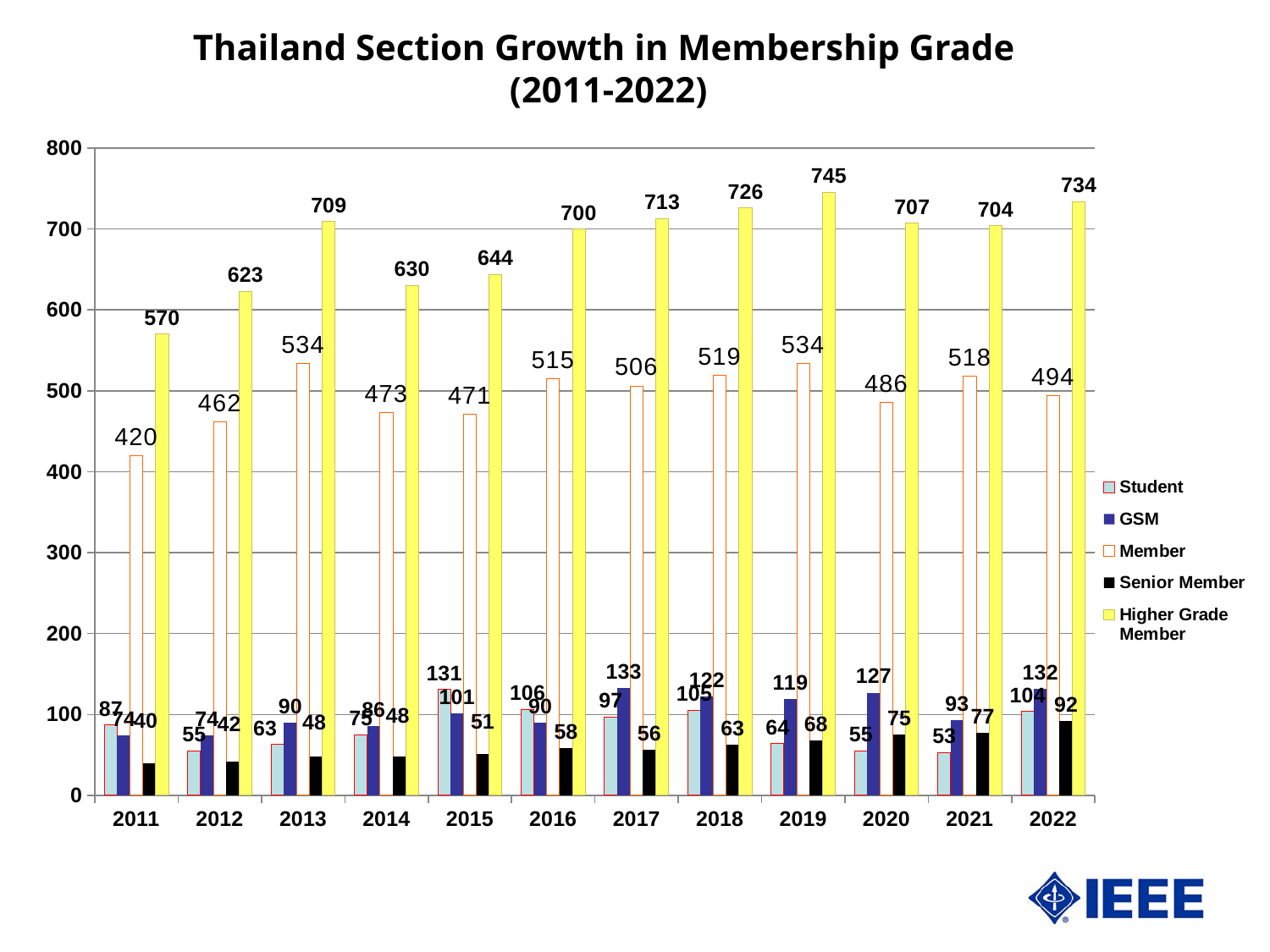
How many years are shown on the x axis? 12 In which year is the Higher Grade Member value highest? 2019 What kind of chart is shown on the slide? bar chart Which is larger, the GSM value for 2017 or the GSM value for 2021? 2017 What is the Student value for 2015? 131 What is the Senior Member value for 2022? 92 Is the Member value for 2020 greater or less than 400? greater In which year is the Member value lowest? 2011 How many series does the legend list? 5 What is the Member value for 2013? 534 What is the Higher Grade Member value for 2019? 745 What is the difference between the Higher Grade Member values for 2022 and 2011? 164